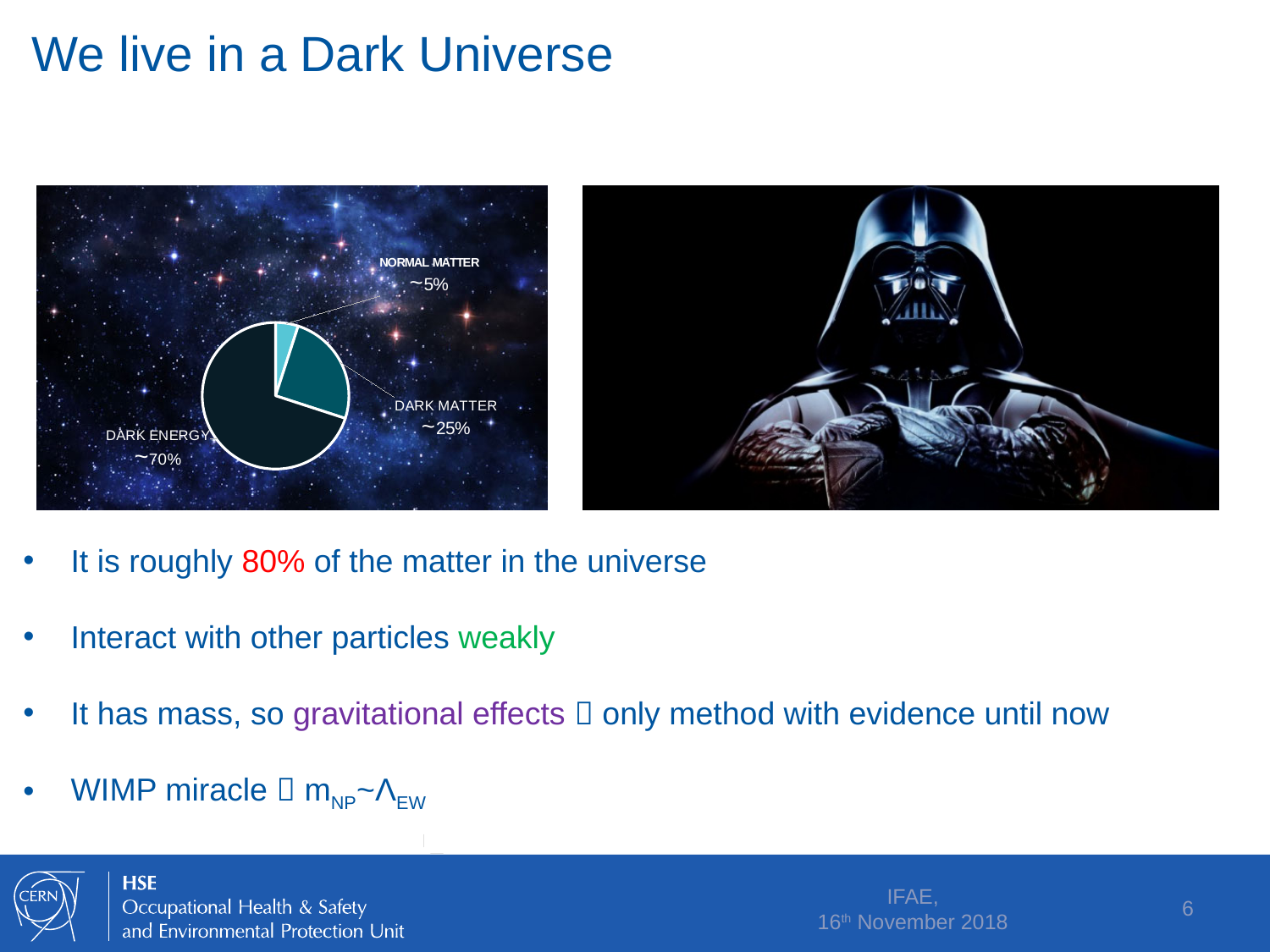
How many slices does the pie chart have? 3 What share of the pie chart is labelled for Dark Energy? ~70% What are the three categories labelled on the pie chart? Dark Energy, Dark Matter, Normal Matter What kind of chart is shown on the left image of the slide? pie chart What share of the pie chart is labelled for Normal Matter? ~5% Which slice of the pie chart is the smallest? Normal Matter Which is larger in the pie chart, Dark Energy or Dark Matter? Dark Energy Is the share for Dark Energy in the pie chart greater or less than 50%? greater What is the title of the slide containing the pie chart? We live in a Dark Universe Which slice of the pie chart is the largest? Dark Energy Which is larger in the pie chart, Dark Matter or Normal Matter? Dark Matter What share of the pie chart is labelled for Dark Matter? ~25%